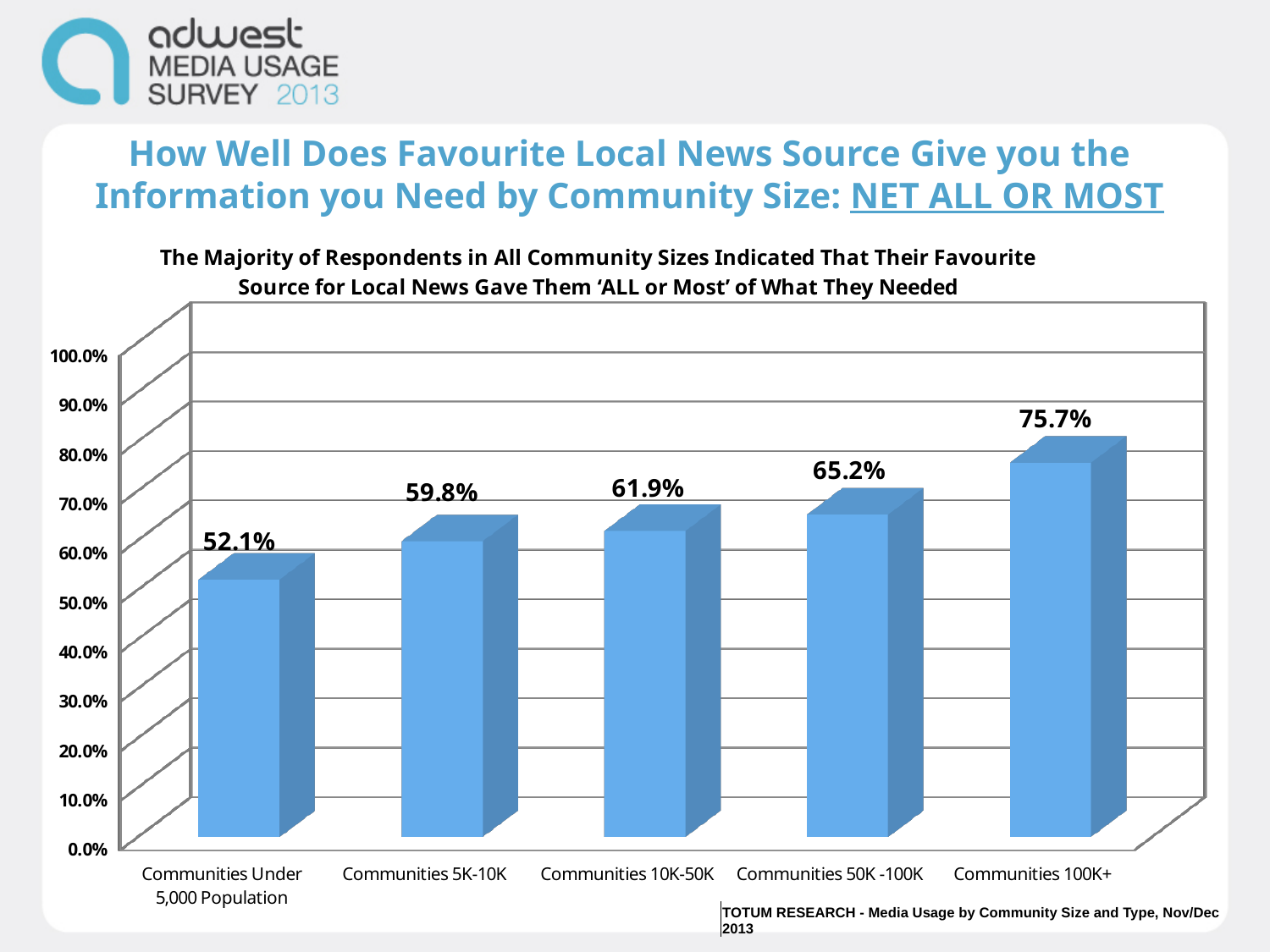
What is the difference between the values for Communities 50K -100K and Communities 5K-10K? 5.4% What is the value for Communities 100K+? 75.7% Is the value for Communities 100K+ greater or less than 70.0%? greater Which community size has the lowest value? Communities Under 5,000 Population How many community size categories are shown in the chart? 5 Which community size has the highest value? Communities 100K+ What is the value for Communities Under 5,000 Population? 52.1% Do the values rise or fall as community size increases from left to right? Rise What is the difference between the values for Communities 100K+ and Communities Under 5,000 Population? 23.6% What kind of chart is shown on the slide? Bar chart Which is larger, the value for Communities 5K-10K or the value for Communities 50K -100K? Communities 50K -100K What is the value for Communities 10K-50K? 61.9%